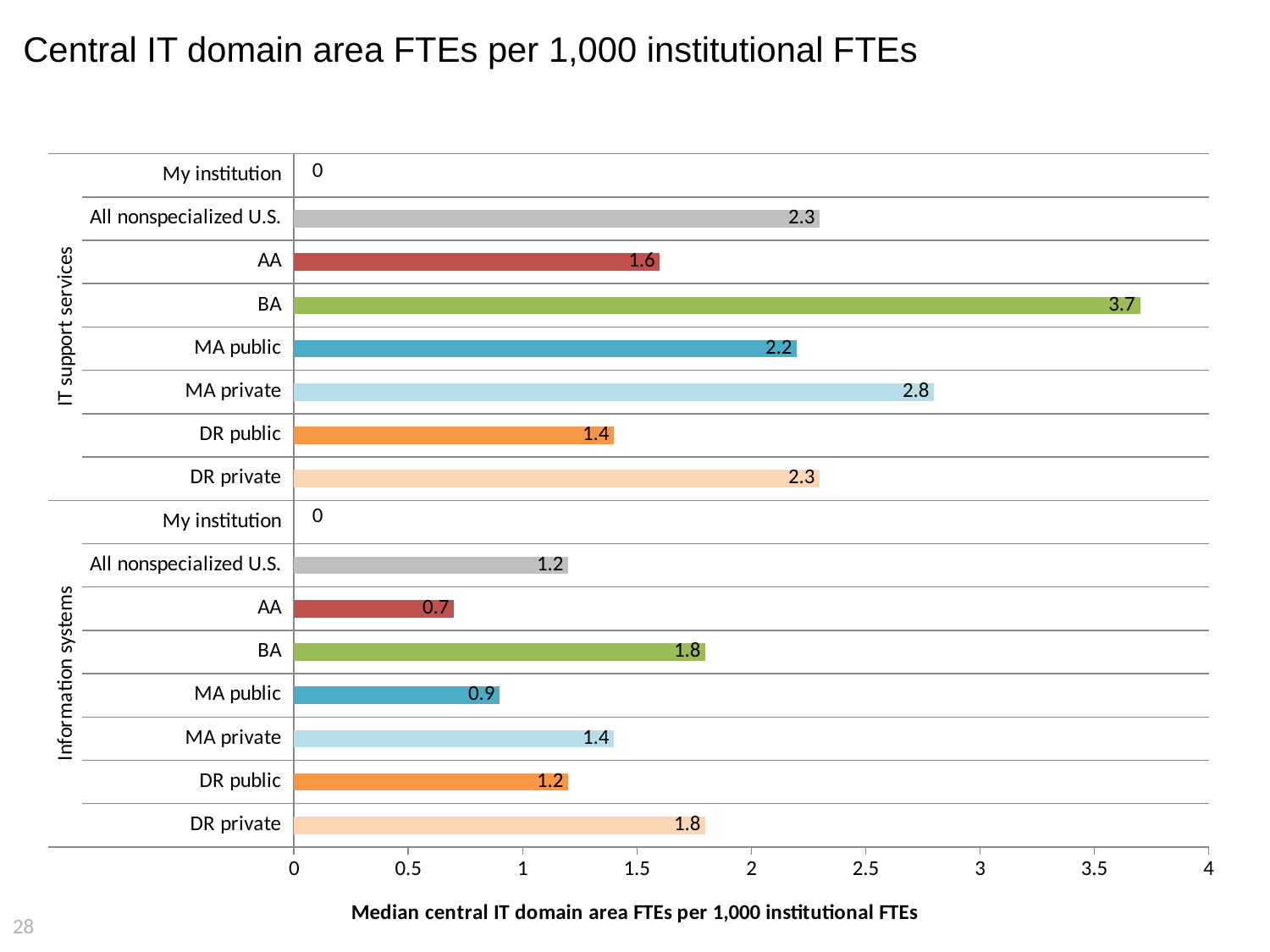
Which category has the highest value in the IT support services group? BA What is the value for BA in the IT support services group? 3.7 Which is larger in the Information systems group: DR private or DR public? DR private What is the value for All nonspecialized U.S. in the Information systems group? 1.2 What is the difference between MA private and MA public in the IT support services group? 0.6 What is the value for MA private in the Information systems group? 1.4 What kind of chart is shown on the slide? Bar chart What is the difference between the BA values in the IT support services group and the Information systems group? 1.9 Is the value for MA private in the IT support services group greater or less than 2.5? greater Which category has the lowest value in the Information systems group, excluding My institution? AA What is the x-axis title of the chart? Median central IT domain area FTEs per 1,000 institutional FTEs How many bars are plotted in the Information systems group? 8